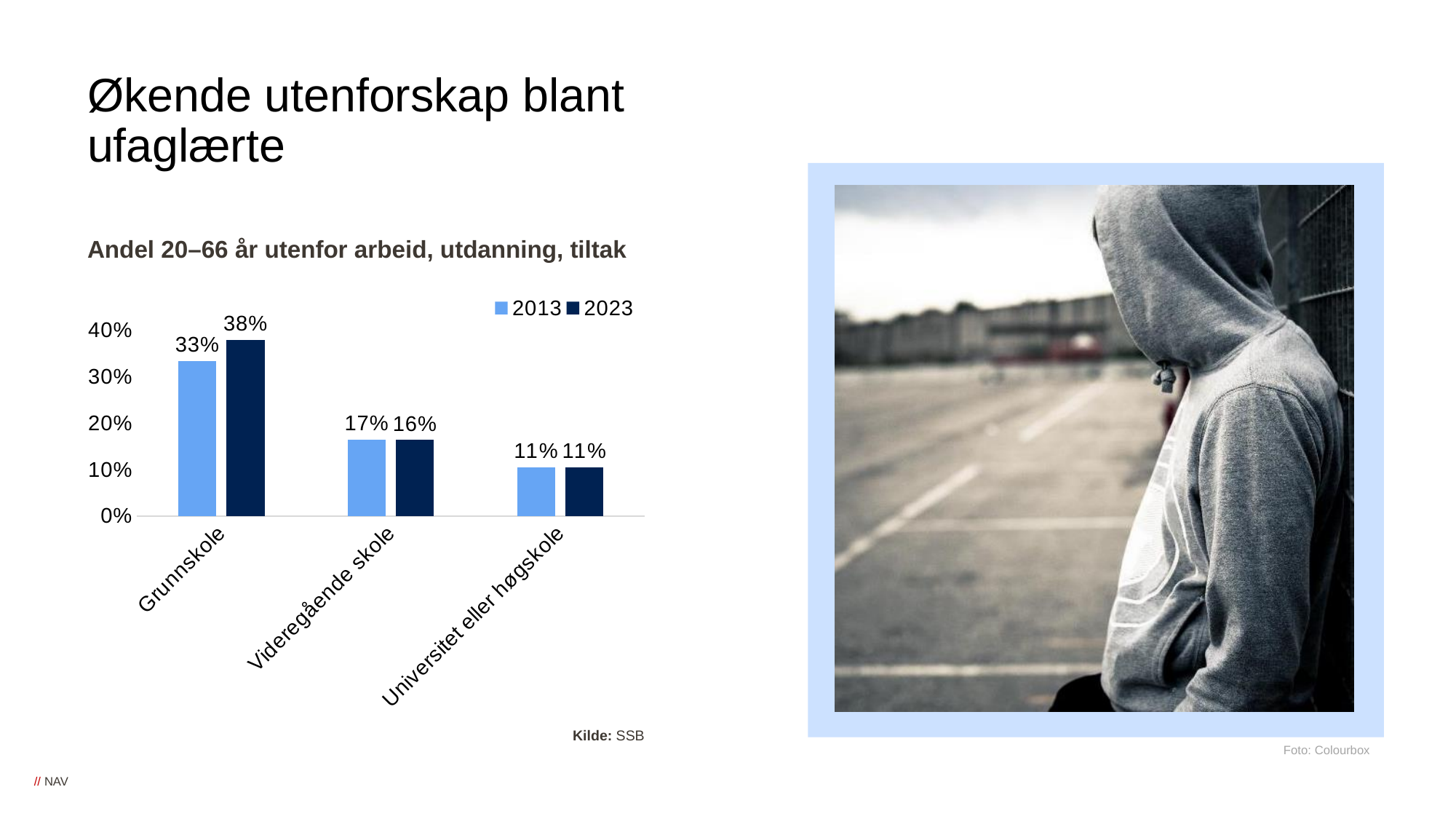
Which category has the lowest value in 2013? Universitet eller høgskole Which category has the highest value in 2023? Grunnskole What is the value for Grunnskole in 2013? 33% Which is larger for Videregående skole: the 2013 value or the 2023 value? 2013 What is the title of the chart? Andel 20–66 år utenfor arbeid, utdanning, tiltak What is the value for Grunnskole in 2023? 38% What is the difference between the 2023 and 2013 values for Grunnskole? 5 percentage points What kind of chart is shown on the slide? Bar chart How many categories are shown on the x axis? 3 What is the value for Videregående skole in 2013? 17% How many series does the legend list? 2 What is the value for Universitet eller høgskole in 2023? 11%